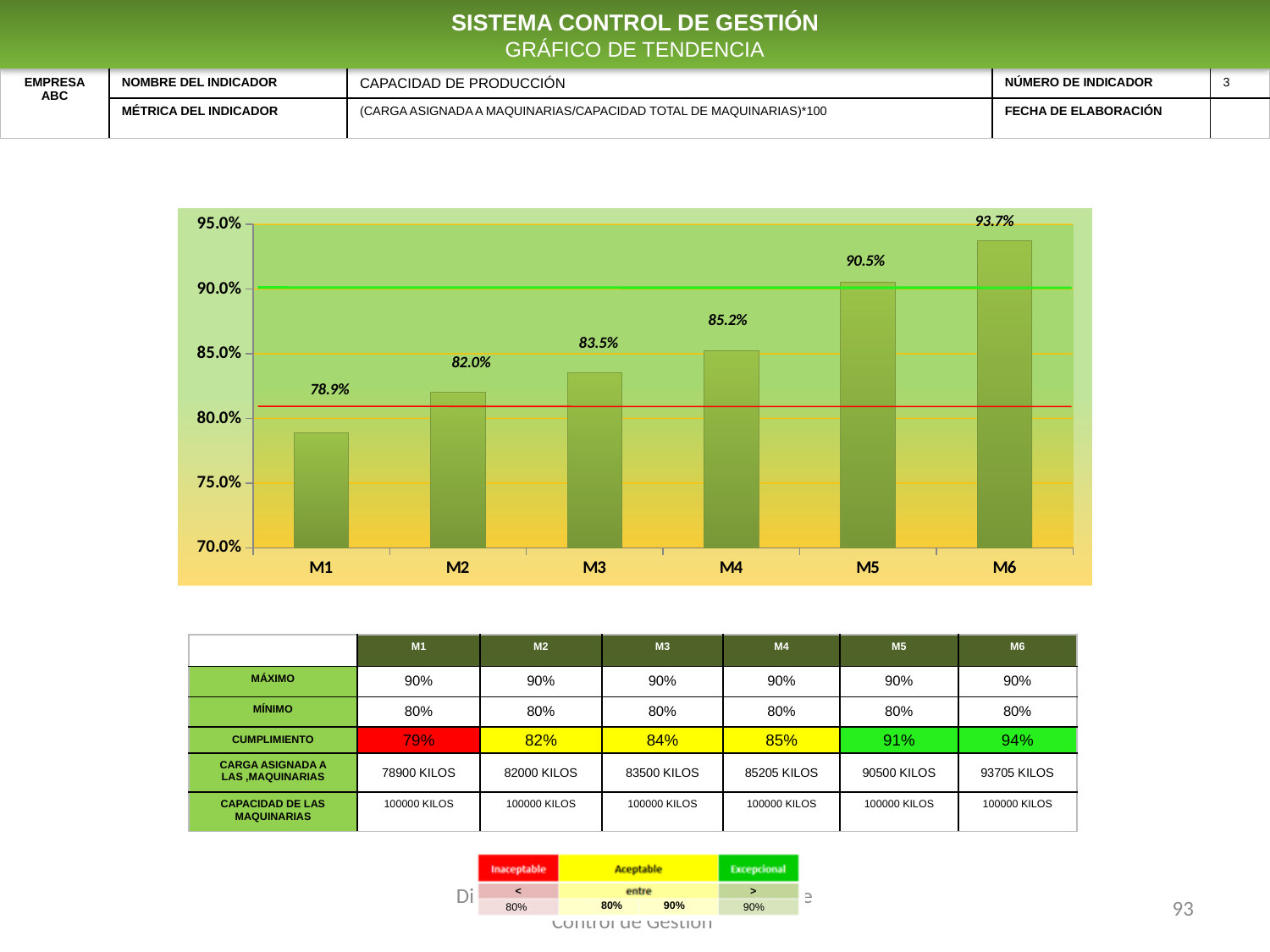
What is the difference between the values for M2 and M1? 3.1% Do the values rise or fall from M1 to M6? rise What is the value for M4? 85.2% What is the value for M6? 93.7% Is the value for M5 greater or less than 90.0%? greater How many categories are shown on the x axis? 6 What is the value for M1? 78.9% Which category has the lowest value? M1 What is the difference between the values for M6 and M5? 3.2% Which is larger, the value for M3 or the value for M4? M4 Which category has the highest value? M6 What kind of chart is shown? bar chart